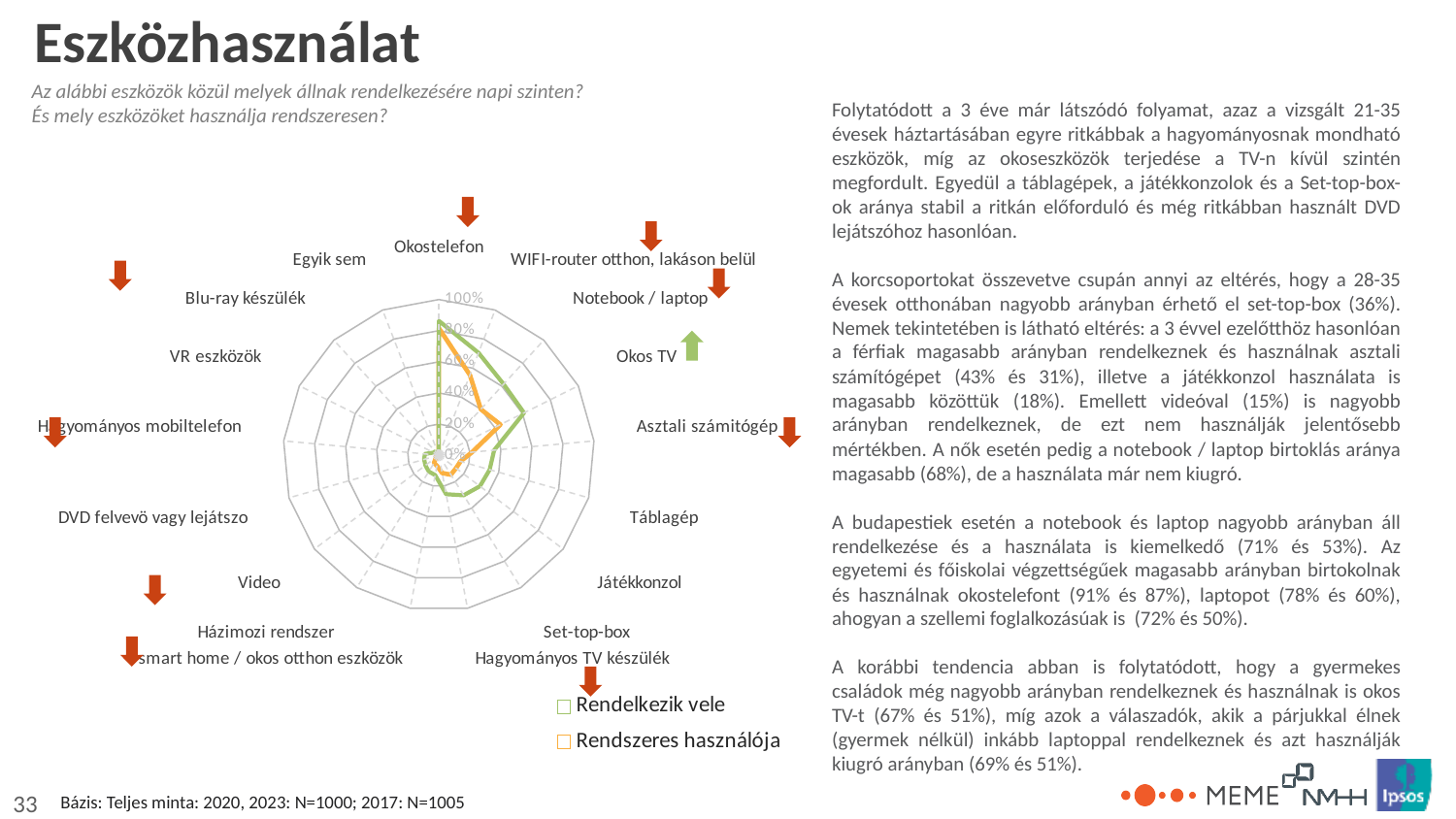
How many device categories are plotted on the radar chart? 17 Is the 'Rendelkezik vele' value for Okostelefon greater or less than 80%? greater What kind of chart is shown on the slide? Radar chart How many series does the chart legend list? 2 Which category has the highest value for the 'Rendelkezik vele' series? Okostelefon Which category has the highest value for the 'Rendszeres használója' series? Okostelefon What is the maximum value shown on the radar chart's axis scale? 100% For Okostelefon, which series has the larger value: 'Rendelkezik vele' or 'Rendszeres használója'? Rendelkezik vele Is the 'Rendszeres használója' value for VR eszközök greater or less than 20%? less What are the two series named in the chart legend? Rendelkezik vele; Rendszeres használója Is the 'Rendelkezik vele' value for Egyik sem greater or less than 20%? less